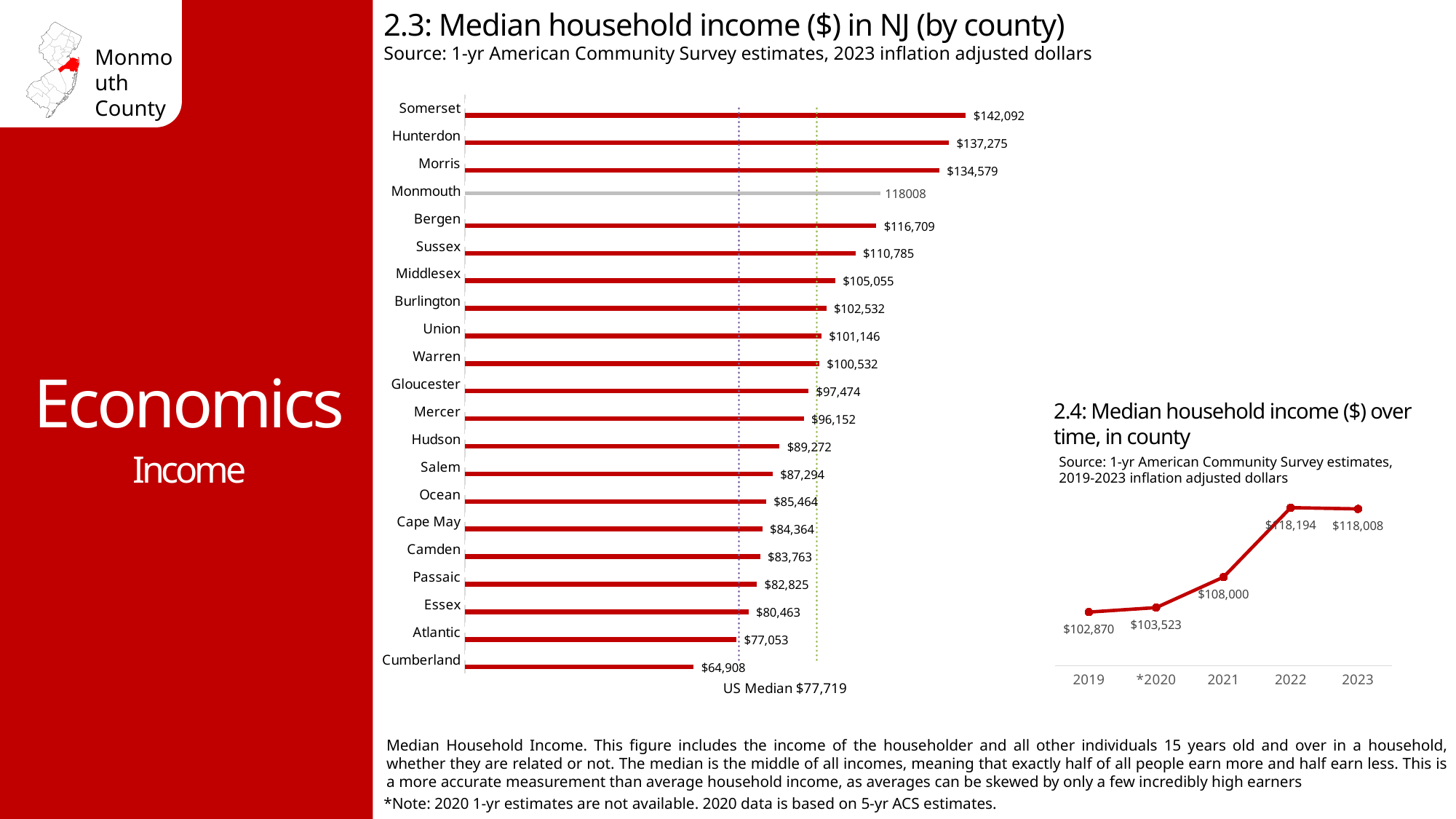
In chart 2.3, which county has the highest median household income? Somerset In chart 2.4, which year has the highest median household income? 2022 What kind of chart is chart 2.4? Line chart In chart 2.4, what is the difference between the median household income in 2022 and 2019? $15,324 In chart 2.3, what is the median household income for Monmouth county? 118008 In chart 2.3, which county has a higher median household income, Bergen or Sussex? Bergen In chart 2.3, how many counties are plotted? 21 In chart 2.3, what is the difference between the median household income of Somerset and Cumberland? $77,184 In chart 2.3, what is the median household income for Somerset county? $142,092 What kind of chart is chart 2.3? Bar chart In chart 2.4, what is the median household income for 2021? $108,000 In chart 2.3, which county has the lowest median household income? Cumberland